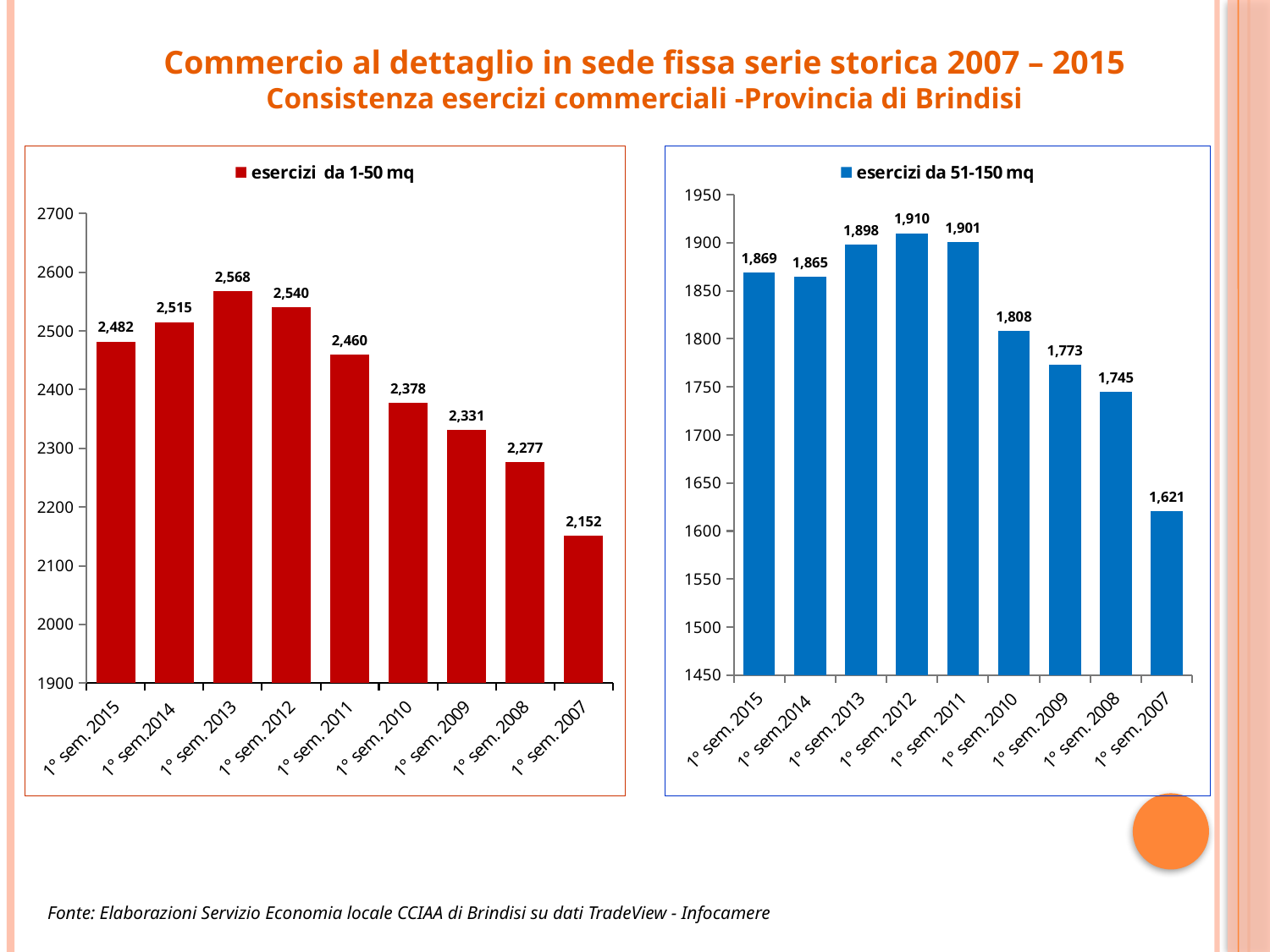
What is the legend entry of the right chart? esercizi da 51-150 mq In the right chart (esercizi da 51-150 mq), what is the difference between the values for 1° sem. 2012 and 1° sem. 2010? 102 In the left chart (esercizi da 1-50 mq), which category has the lowest value? 1° sem. 2007 In the left chart (esercizi da 1-50 mq), is the value for 1° sem. 2010 greater or less than 2400? less How many categories are shown on the x axis of the left chart (esercizi da 1-50 mq)? 9 In the left chart (esercizi da 1-50 mq), what is the difference between the values for 1° sem. 2015 and 1° sem. 2007? 330 In the right chart (esercizi da 51-150 mq), what is the value for 1° sem. 2007? 1,621 In the right chart (esercizi da 51-150 mq), which is larger: the value for 1° sem. 2015 or 1° sem. 2009? 1° sem. 2015 In the right chart (esercizi da 51-150 mq), which category has the highest value? 1° sem. 2012 In the left chart (esercizi da 1-50 mq), do the values rise or fall from 1° sem. 2012 to 1° sem. 2007 along the x axis? fall In the left chart (esercizi da 1-50 mq), what is the value for 1° sem. 2013? 2,568 What kind of chart is the right chart (esercizi da 51-150 mq)? bar chart